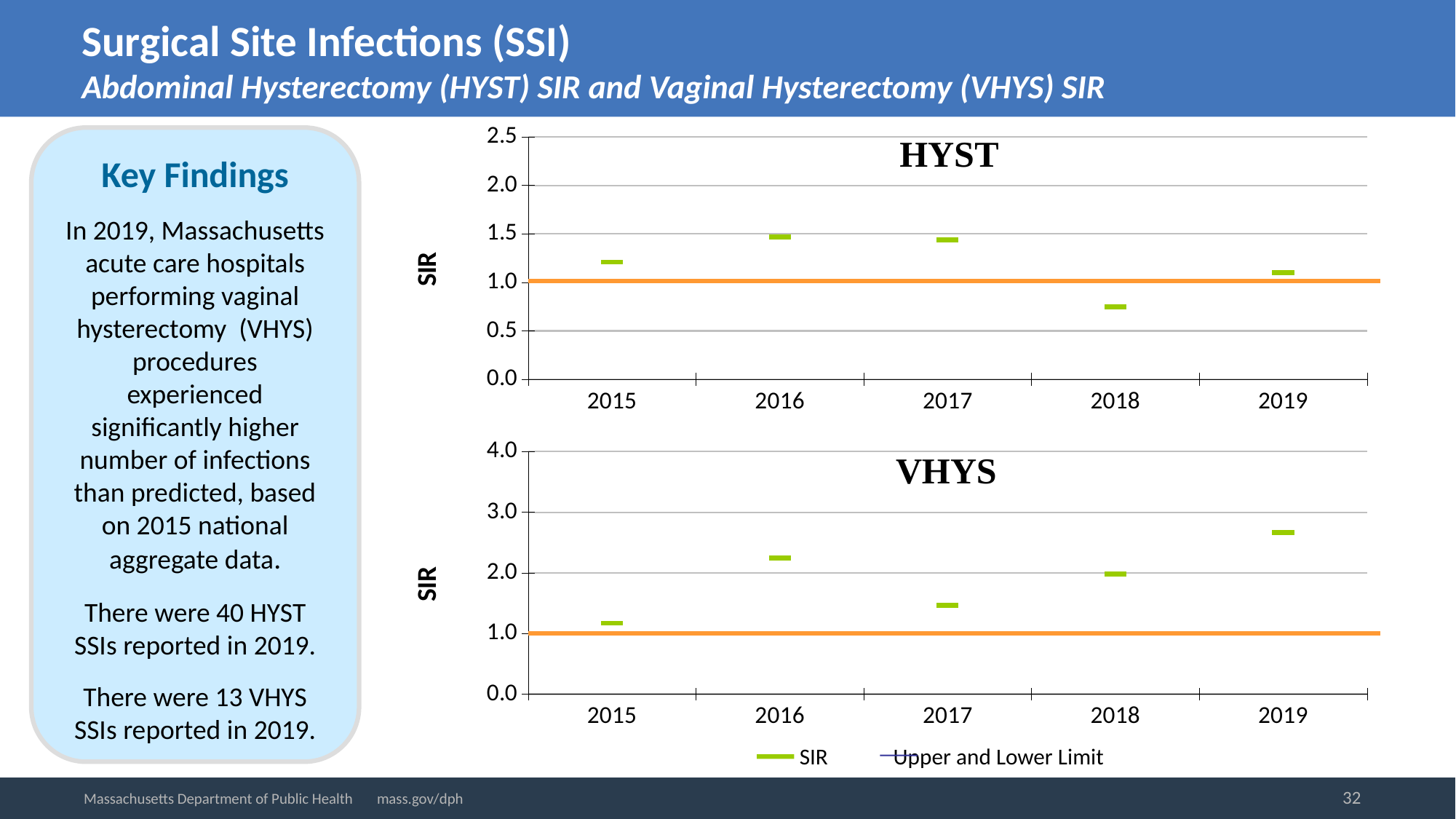
What is the label on the y axis of the HYST chart? SIR In the VHYS chart, is the SIR value for 2017 greater or less than 2.0? less In the HYST chart, which year has the lowest SIR? 2018 In the VHYS chart, which is larger, the SIR for 2016 or the SIR for 2018? 2016 In the VHYS chart, which year has the lowest SIR? 2015 How many series does the legend below the VHYS chart list? 2 How many years are plotted on the x axis of the HYST chart? 5 In the VHYS chart, is the SIR value for 2019 greater or less than 2.0? greater In the HYST chart, which is larger, the SIR for 2015 or the SIR for 2018? 2015 In the HYST chart, is the SIR value for 2018 greater or less than 1.0? less In the VHYS chart, which year has the highest SIR? 2019